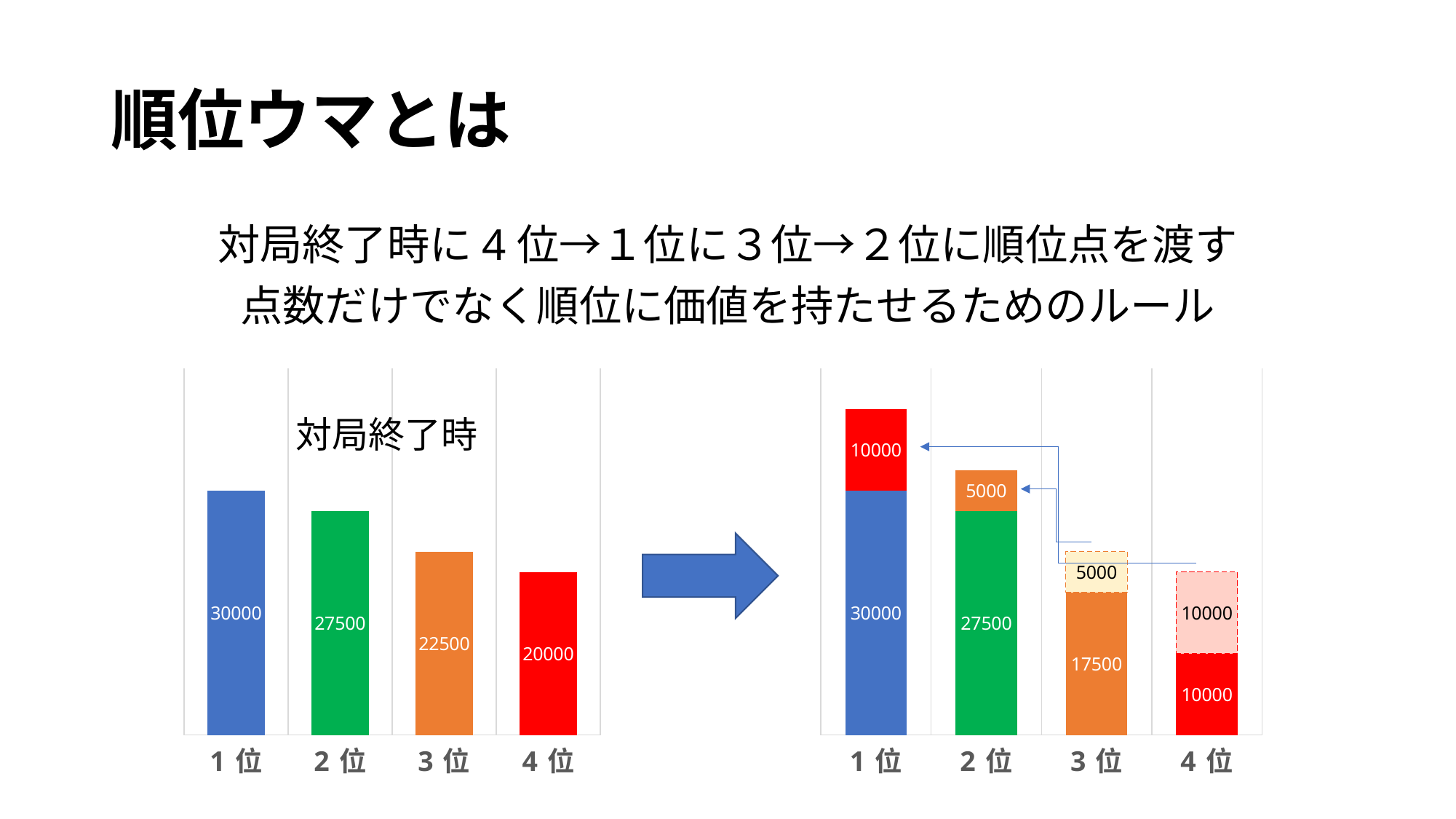
What kind of chart is the left chart titled 対局終了時? bar chart In the right chart, what is the value of the solid orange segment of the 3位 bar? 17500 In the left chart titled 対局終了時, how many categories are shown on the x axis? 4 In the left chart titled 対局終了時, which category has the lowest value? 4位 In the left chart titled 対局終了時, do the values rise or fall from 1位 to 4位? fall In the left chart titled 対局終了時, which category has the highest value? 1位 In the left chart titled 対局終了時, what is the value for 1位? 30000 In the right chart, what is the total of the stacked bar for 1位? 40000 In the right chart, what is the total of the stacked bar for 2位? 32500 In the right chart, what is the value of the red segment on top of the 1位 bar? 10000 In the left chart titled 対局終了時, what is the difference between the values for 2位 and 4位? 7500 In the left chart titled 対局終了時, what is the value for 3位? 22500